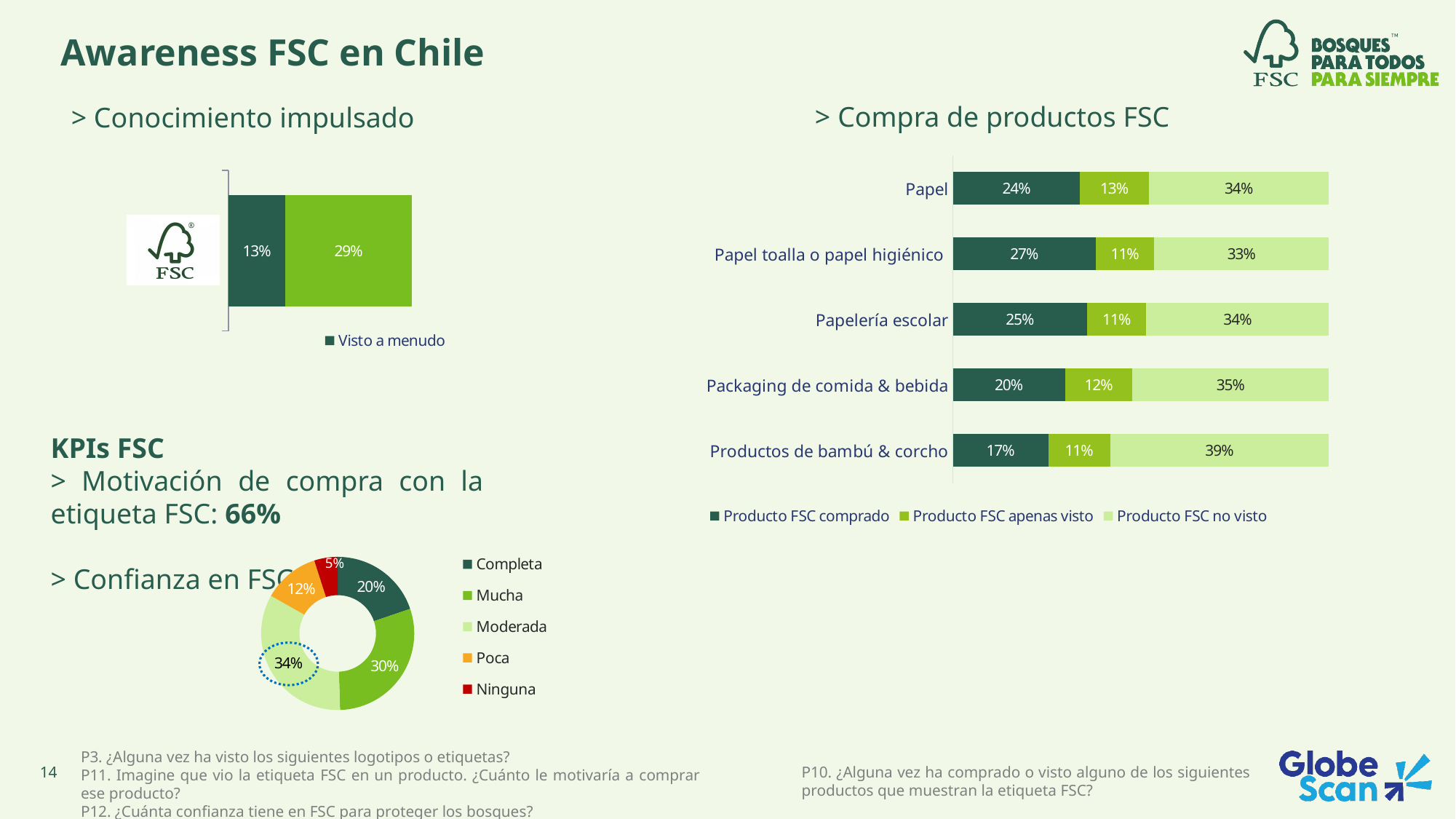
How many series does the legend of the 'Compra de productos FSC' chart list? 3 In the 'Confianza en FSC' chart, what share does 'Moderada' have? 34% In the 'Compra de productos FSC' chart, what is the difference between the 'Producto FSC comprado' values for Papel and Packaging de comida & bebida? 4% How many product categories are shown in the 'Compra de productos FSC' chart? 5 In the 'Confianza en FSC' chart, which category has the smallest slice? Ninguna What kind of chart is the 'Confianza en FSC' chart? Donut (pie) chart In the 'Compra de productos FSC' chart, what is the value of 'Producto FSC no visto' for Productos de bambú & corcho? 39% In the 'Compra de productos FSC' chart, which category has the highest 'Producto FSC comprado' value? Papel toalla o papel higiénico In the 'Compra de productos FSC' chart, what is the value of 'Producto FSC comprado' for Papel toalla o papel higiénico? 27% In the 'Conocimiento impulsado' chart, what is the value of the light green segment? 29% In the 'Compra de productos FSC' chart, which category has the lowest 'Producto FSC comprado' value? Productos de bambú & corcho In the 'Compra de productos FSC' chart, what is the total of the three segments for Papel? 71%